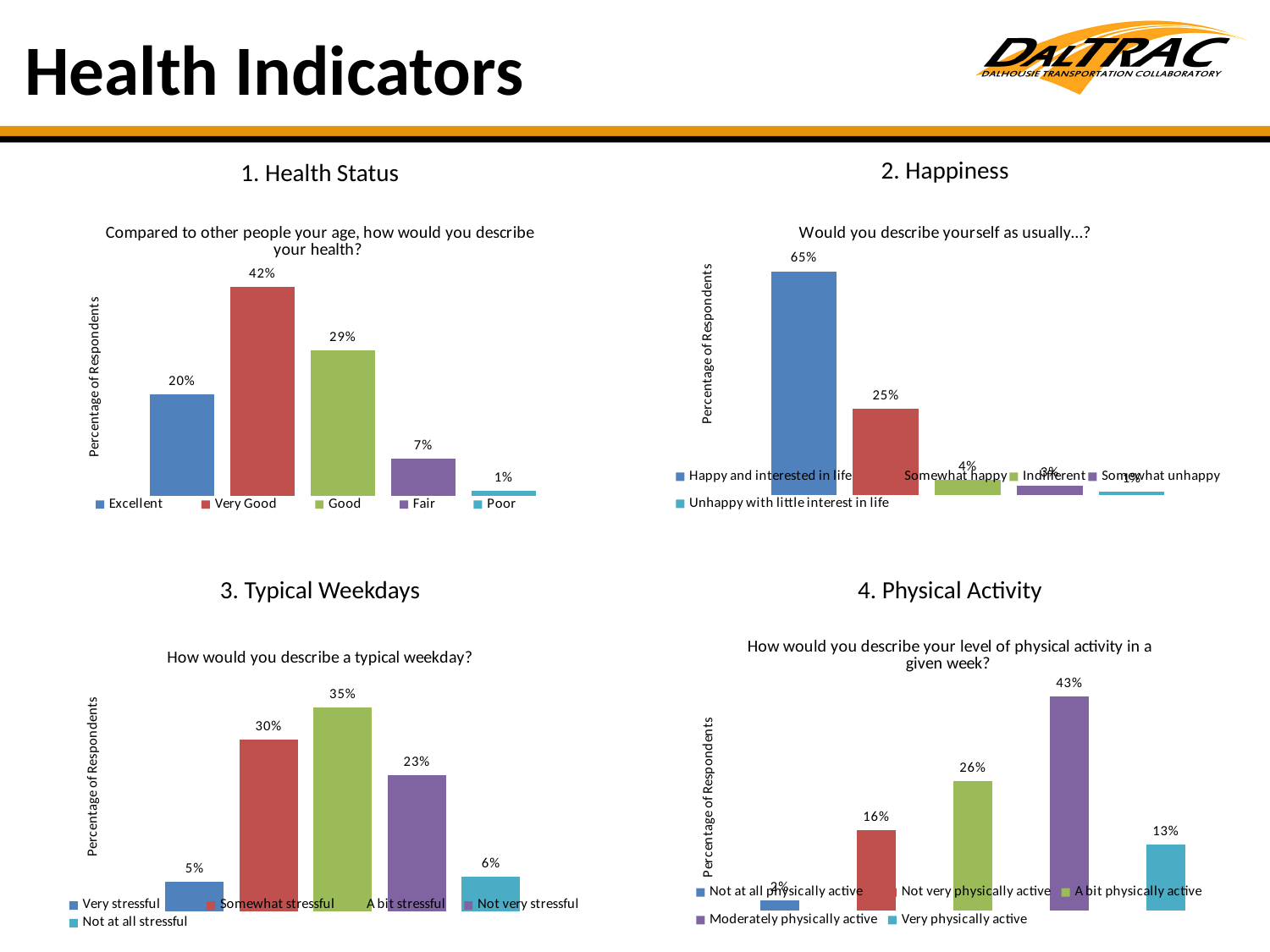
In the Physical Activity chart, what percentage of respondents are Moderately physically active? 43% In the Happiness chart, what percentage of respondents described themselves as Happy and interested in life? 65% In the Happiness chart, which category has the highest percentage? Happy and interested in life In the Typical Weekdays chart, what is the difference between Not at all stressful and Very stressful? 1% In the Typical Weekdays chart, what percentage of respondents said a typical weekday is A bit stressful? 35% In the Health Status chart, what percentage of respondents described their health as Very Good? 42% In the Physical Activity chart, which category has the lowest percentage? Not at all physically active In the Health Status chart, what is the difference between the Good and Fair percentages? 22% In the Happiness chart, how many categories does the legend list? 5 In the Health Status chart, which category has the lowest percentage? Poor In the Typical Weekdays chart, which is larger: Somewhat stressful or Not very stressful? Somewhat stressful What type of chart is used in the Physical Activity section? Bar chart